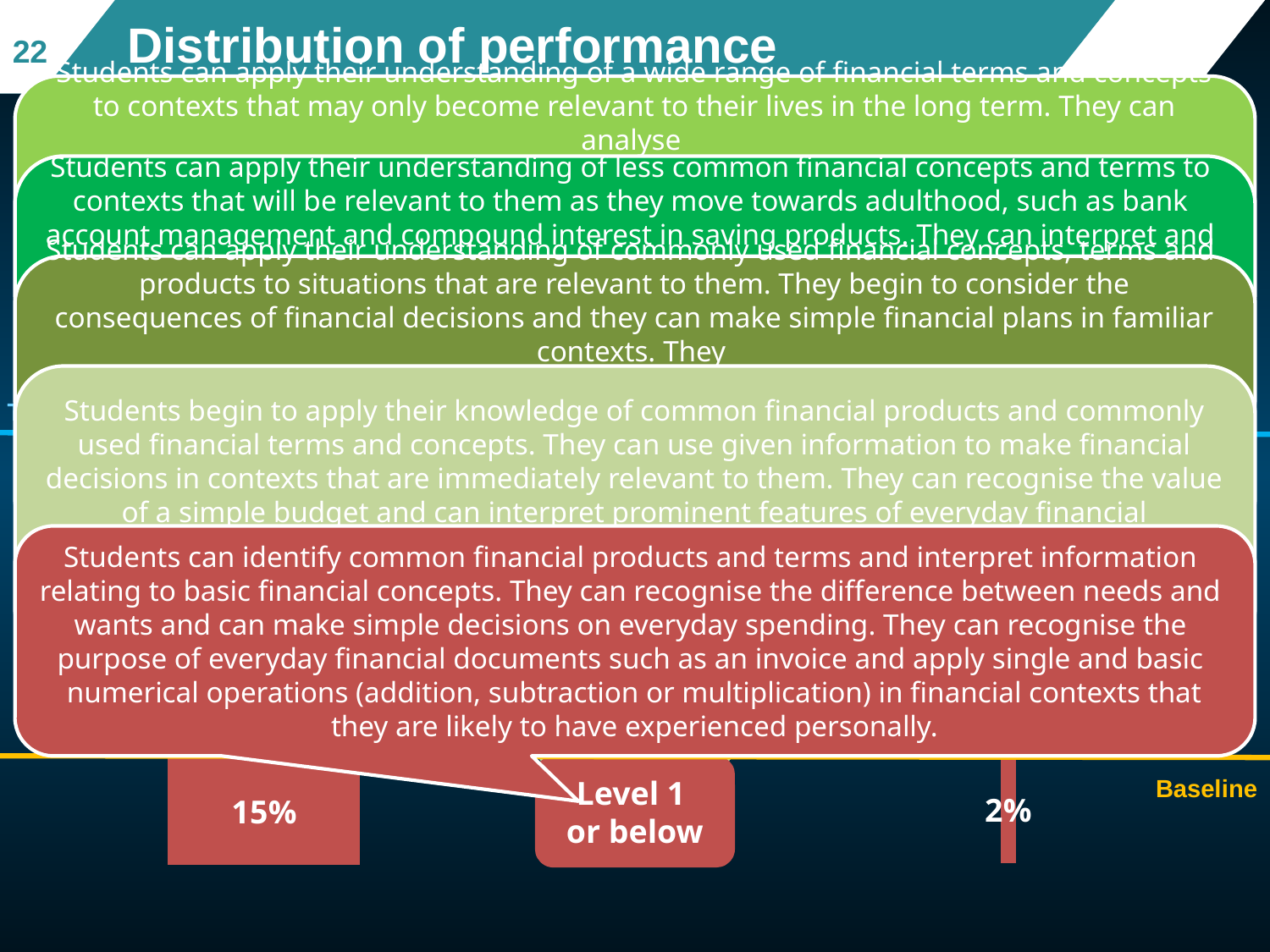
What is the title of the slide's chart? Distribution of performance What value is printed on the left red bar below the baseline? 15% How many red bars with printed values are visible below the baseline? 2 Which performance level do the red bars below the baseline represent, according to the label on the chart? Level 1 or below What is the difference between the two visible red bar values, 15% and 2%? 13% What kind of chart is shown on the slide? bar chart Which of the two visible red bars is larger, the left one (15%) or the right one (2%)? the left one What value is printed on the right red bar below the baseline? 2%